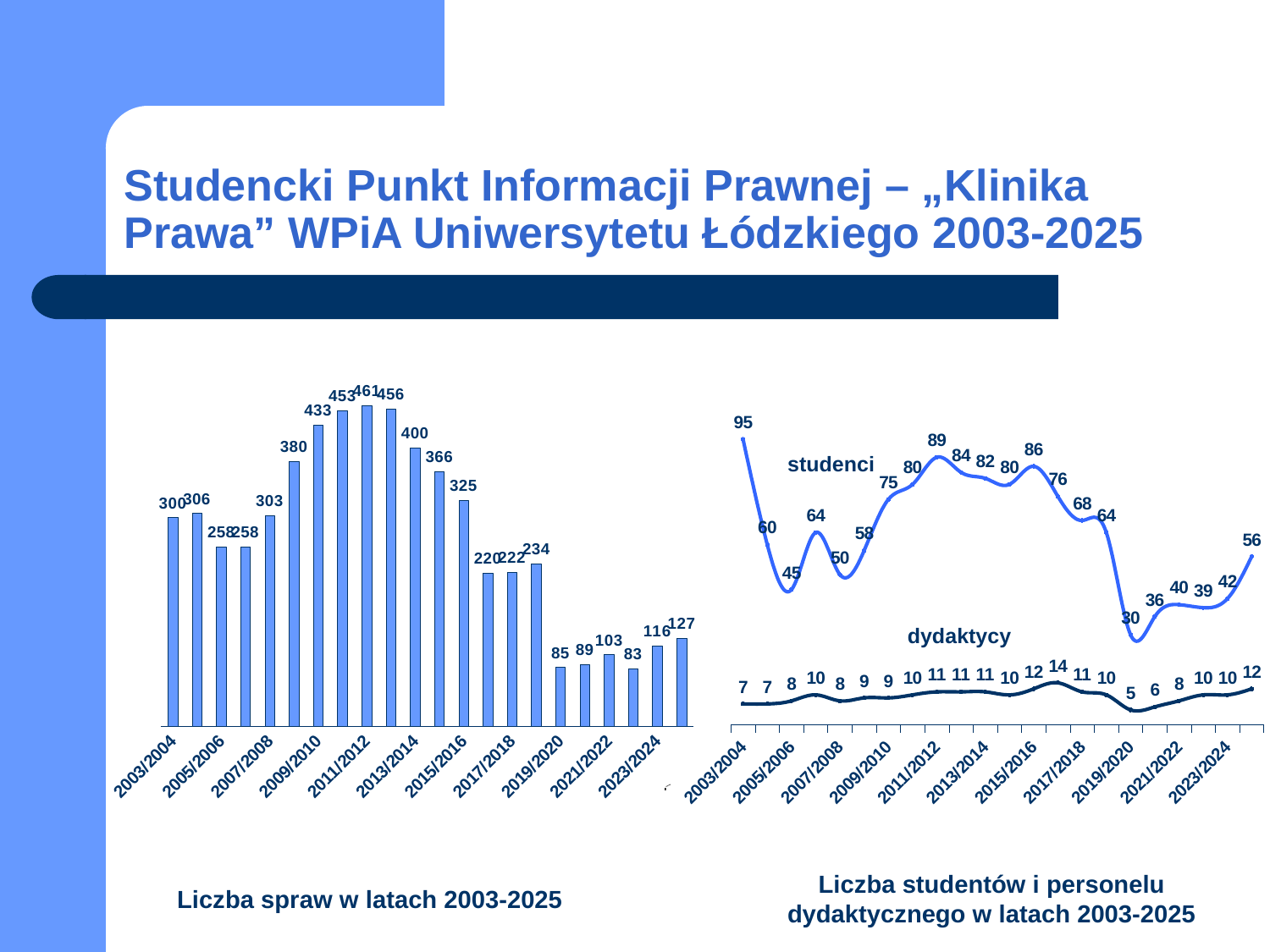
In the left chart 'Liczba spraw w latach 2003-2025', what is the value for 2011/2012? 461 In the right chart 'Liczba studentów i personelu dydaktycznego w latach 2003-2025', what is the lowest value of the 'studenci' series? 30 How many bars are plotted in the left chart 'Liczba spraw w latach 2003-2025'? 22 What kind of chart is the left chart, 'Liczba spraw w latach 2003-2025'? bar chart In the left chart 'Liczba spraw w latach 2003-2025', what is the difference between the values for 2009/2010 and 2013/2014? 33 In the left chart 'Liczba spraw w latach 2003-2025', what is the value for 2019/2020? 85 In the right chart 'Liczba studentów i personelu dydaktycznego w latach 2003-2025', what is the value of 'studenci' for 2003/2004? 95 How many series are plotted in the right chart 'Liczba studentów i personelu dydaktycznego w latach 2003-2025'? 2 In the right chart 'Liczba studentów i personelu dydaktycznego w latach 2003-2025', what is the difference between the 'studenci' and 'dydaktycy' values for 2011/2012? 78 In the right chart 'Liczba studentów i personelu dydaktycznego w latach 2003-2025', what is the value of 'dydaktycy' for 2019/2020? 5 In the left chart 'Liczba spraw w latach 2003-2025', which is larger, the value for 2003/2004 or the value for 2007/2008? 2007/2008 In the left chart 'Liczba spraw w latach 2003-2025', which year has the highest value? 2011/2012